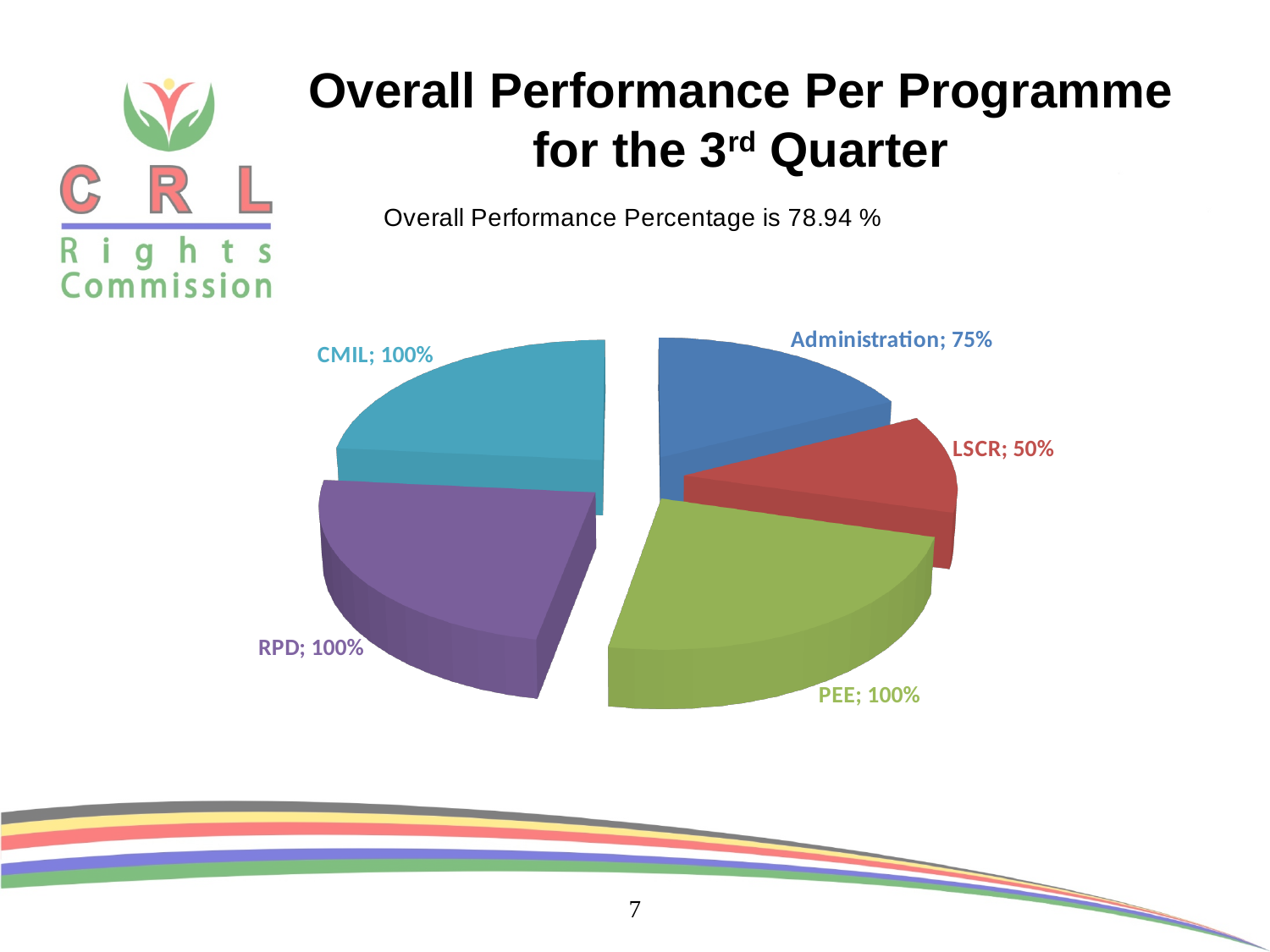
What is the performance value shown for Administration? 75% What kind of chart is shown on the slide? Pie chart How many programmes are labelled with a value of 100%? 3 What is the title of the chart on the slide? Overall Performance Percentage is 78.94 % What is the performance value shown for CMIL? 100% Which has a larger value, Administration or RPD? RPD What overall performance percentage is stated on the slide? 78.94 % What is the performance value shown for LSCR? 50% What is the performance value shown for PEE? 100% What is the difference between the values for Administration and LSCR? 25% How many programmes (slices) are shown in the pie chart? 5 Which programme has the lowest performance value in the pie chart? LSCR